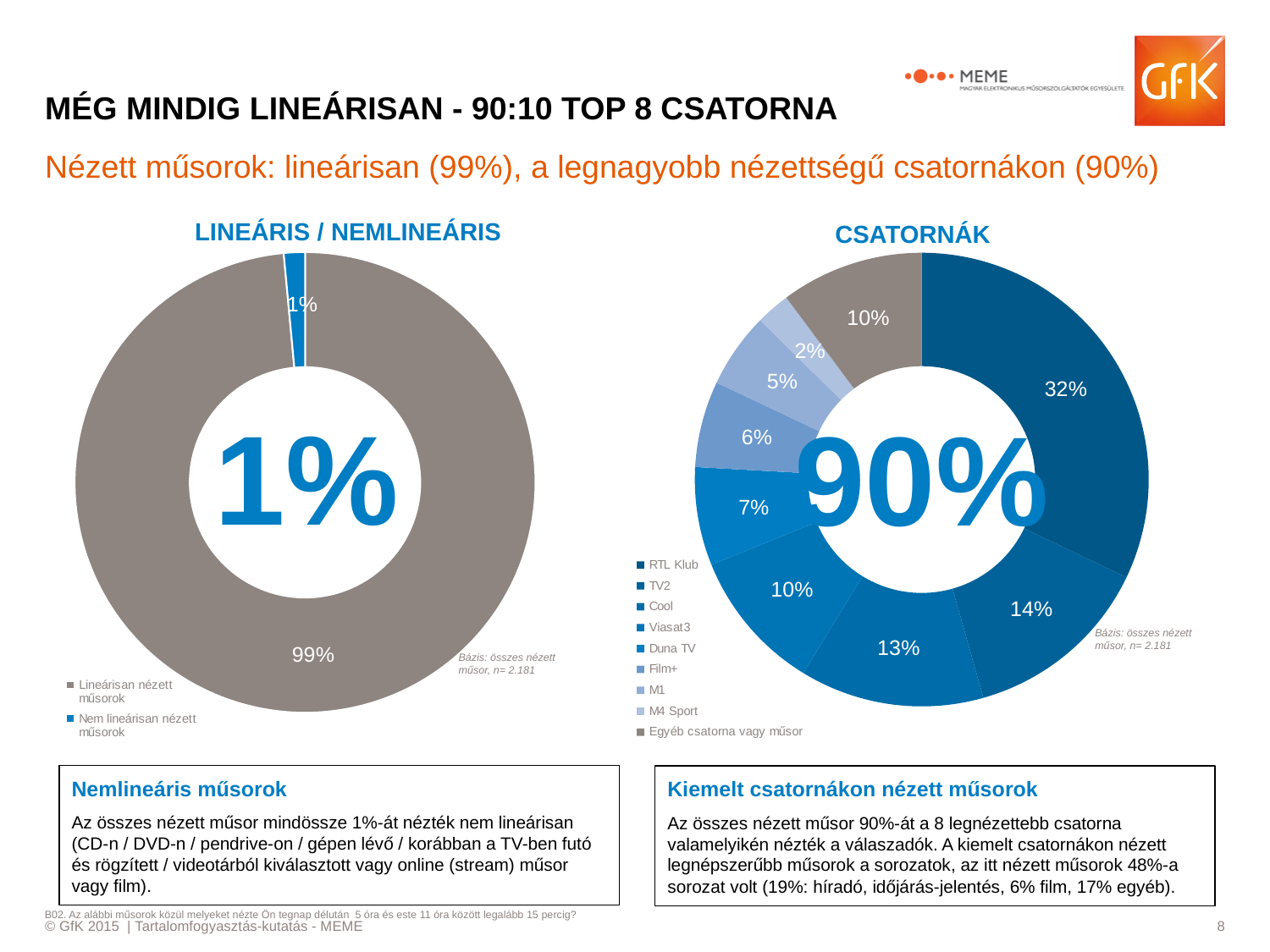
In the CSATORNÁK chart, which has a larger share, Cool or Duna TV? Cool In the CSATORNÁK chart, what share is labelled for M4 Sport? 2% In the CSATORNÁK chart, which channel has the largest share? RTL Klub In the CSATORNÁK chart, what is the difference between the shares of RTL Klub and TV2? 18% What kind of chart is the LINEÁRIS / NEMLINEÁRIS chart? Doughnut chart In the CSATORNÁK chart, what share is labelled for TV2? 14% In the CSATORNÁK chart, which channel has the smallest share? M4 Sport In the LINEÁRIS / NEMLINEÁRIS chart, what share is labelled for Lineárisan nézett műsorok? 99% In the LINEÁRIS / NEMLINEÁRIS chart, what share is labelled for Nem lineárisan nézett műsorok? 1% How many categories does the legend of the CSATORNÁK chart list? 9 How many categories does the legend of the LINEÁRIS / NEMLINEÁRIS chart list? 2 In the CSATORNÁK chart, what share is labelled for RTL Klub? 32%